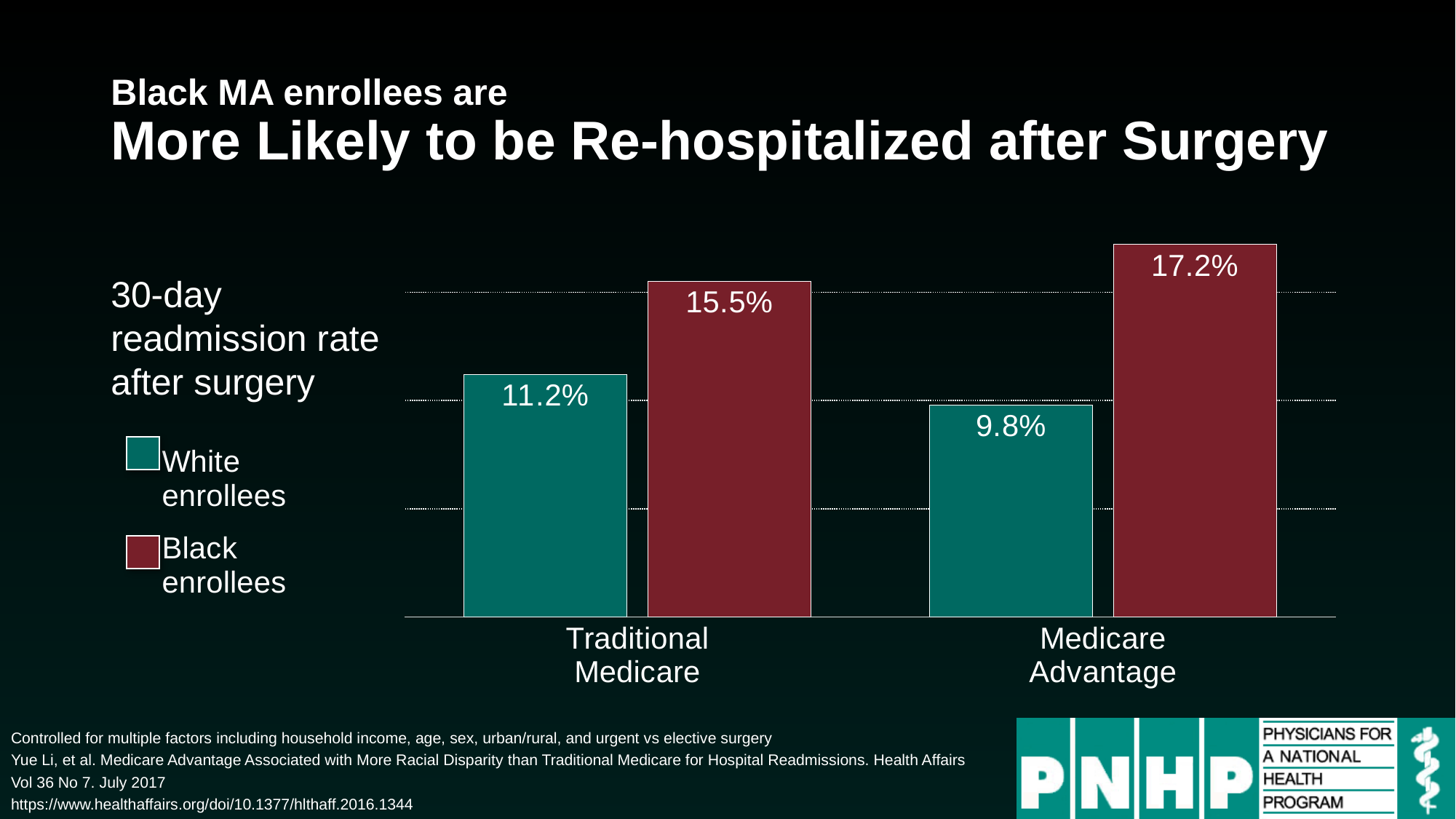
What is the 30-day readmission rate after surgery for White enrollees in Medicare Advantage? 9.8% What is the 30-day readmission rate after surgery for Black enrollees in Traditional Medicare? 15.5% What kind of chart is shown on the slide? Bar chart What is the difference in readmission rate between Black and White enrollees in Traditional Medicare? 4.3% Which group has the lowest 30-day readmission rate shown on the chart? White enrollees in Medicare Advantage What is the 30-day readmission rate after surgery for White enrollees in Traditional Medicare? 11.2% What is the difference in readmission rate between Black and White enrollees in Medicare Advantage? 7.4% How many series does the legend list? 2 Is the readmission rate for Black enrollees higher in Traditional Medicare or in Medicare Advantage? Medicare Advantage Which group has the highest 30-day readmission rate shown on the chart? Black enrollees in Medicare Advantage What colour represents Black enrollees in the chart? Dark red What is the 30-day readmission rate after surgery for Black enrollees in Medicare Advantage? 17.2%